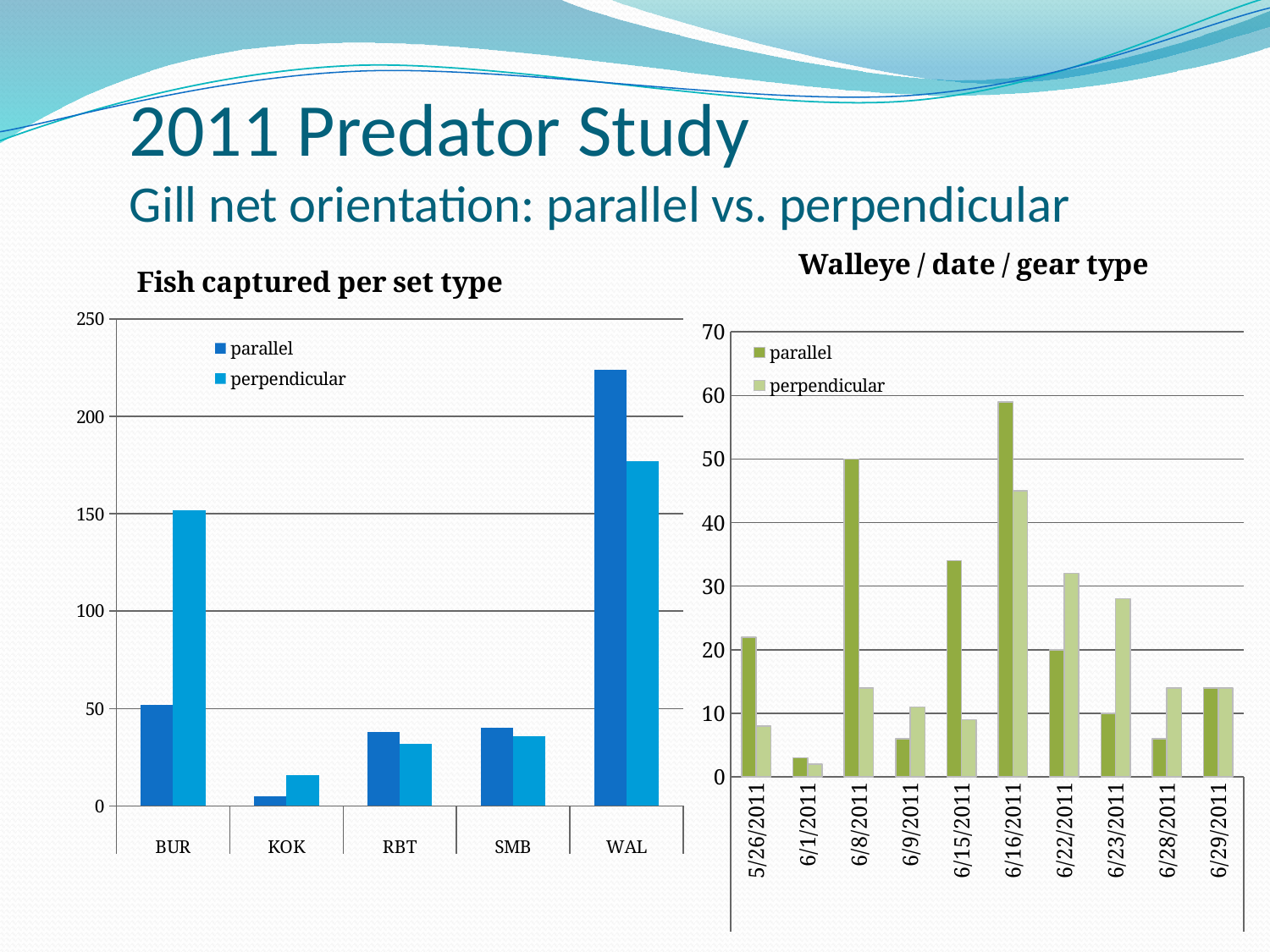
What kind of chart is the 'Fish captured per set type' chart? bar chart In the 'Fish captured per set type' chart, is the perpendicular value for BUR greater or less than 100? greater In the 'Fish captured per set type' chart, which category has the highest parallel value? WAL In the 'Walleye / date / gear type' chart, is the parallel value for 6/8/2011 greater or less than 40? greater In the 'Fish captured per set type' chart, which category has the lowest parallel value? KOK In the 'Walleye / date / gear type' chart, which date has the highest parallel value? 6/16/2011 How many dates are shown on the x axis of the 'Walleye / date / gear type' chart? 10 In the 'Fish captured per set type' chart, which is larger for BUR: parallel or perpendicular? perpendicular In the 'Walleye / date / gear type' chart, which is larger for 6/22/2011: parallel or perpendicular? perpendicular How many fish species categories are shown on the x axis of the 'Fish captured per set type' chart? 5 In the 'Walleye / date / gear type' chart, which date has the lowest perpendicular value? 6/1/2011 How many series does the legend of the 'Fish captured per set type' chart list? 2